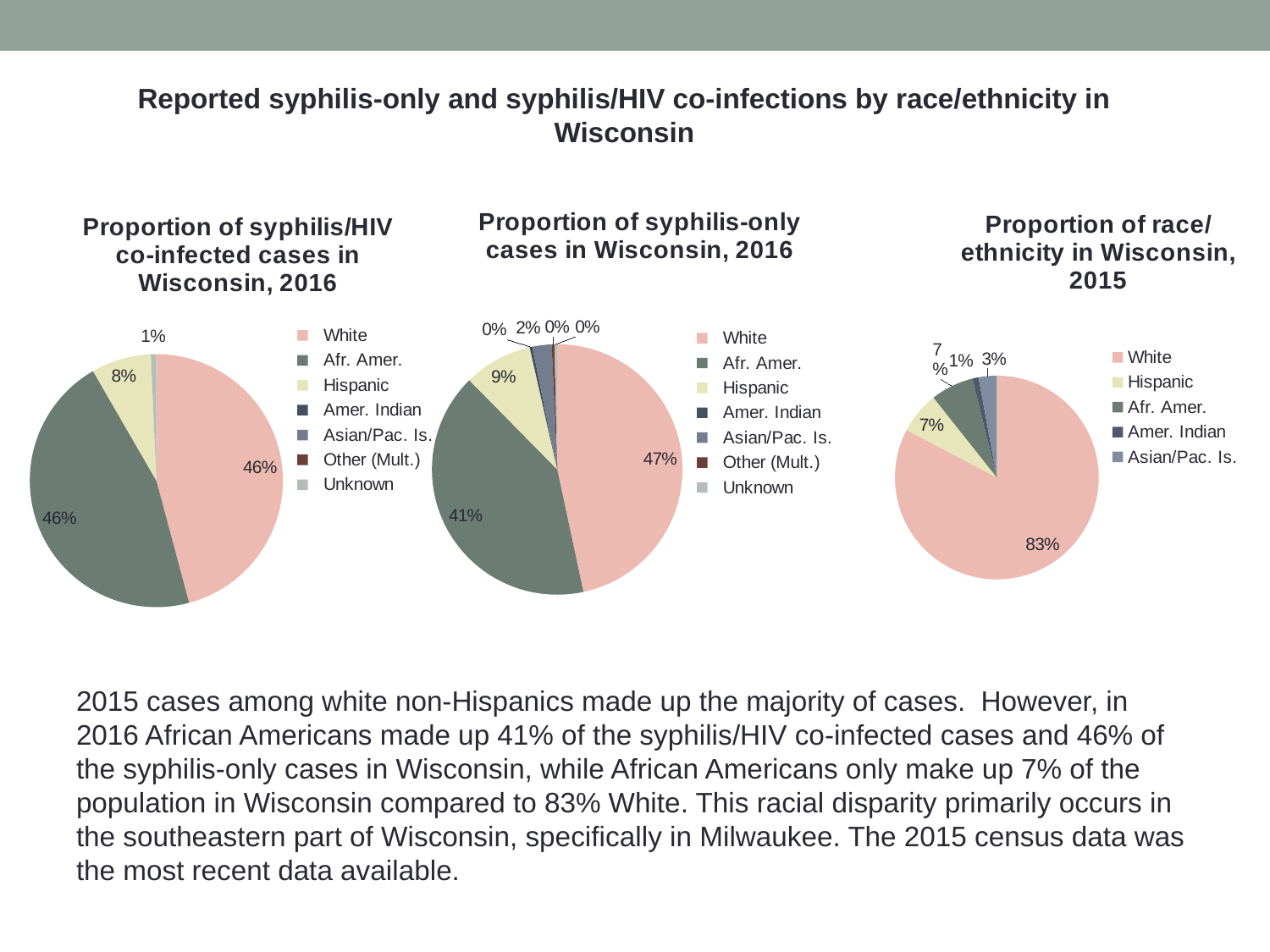
In the 'Proportion of race/ethnicity in Wisconsin, 2015' chart, what share is labelled for Asian/Pac. Is.? 3% In the 'Proportion of syphilis/HIV co-infected cases in Wisconsin, 2016' chart, what share is labelled for Hispanic? 8% What type of charts are shown on the slide? Pie charts In the 'Proportion of syphilis-only cases in Wisconsin, 2016' chart, what share is labelled for Hispanic? 9% In the 'Proportion of syphilis/HIV co-infected cases in Wisconsin, 2016' chart, what share is labelled for White? 46% In the 'Proportion of syphilis-only cases in Wisconsin, 2016' chart, which category has the largest slice? White In the 'Proportion of syphilis-only cases in Wisconsin, 2016' chart, what share is labelled for Afr. Amer.? 41% How many entries does the legend of the 'Proportion of race/ethnicity in Wisconsin, 2015' chart list? 5 In the 'Proportion of race/ethnicity in Wisconsin, 2015' chart, what share is labelled for White? 83% In the 'Proportion of race/ethnicity in Wisconsin, 2015' chart, which category has the largest slice? White In the 'Proportion of syphilis-only cases in Wisconsin, 2016' chart, what is the difference between the White and Afr. Amer. shares? 6% How many entries does the legend of the 'Proportion of syphilis-only cases in Wisconsin, 2016' chart list? 7